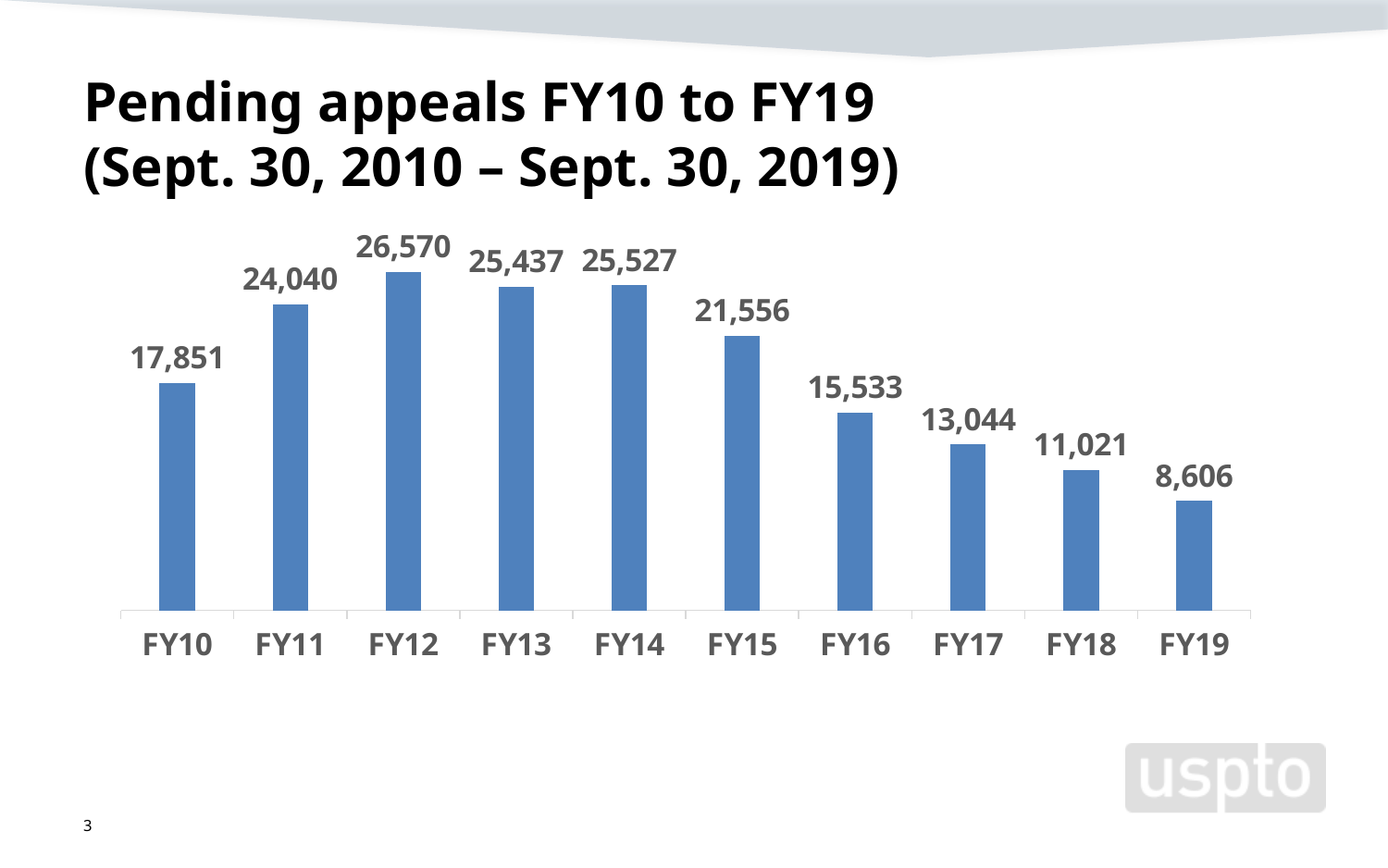
What is the title of the chart on the slide? Pending appeals FY10 to FY19 (Sept. 30, 2010 – Sept. 30, 2019) Which has more pending appeals, FY16 or FY17? FY16 How many fiscal years are shown on the chart? 10 What kind of chart is shown on the slide? Bar chart Do pending appeals rise or fall from FY14 to FY19? Fall Which fiscal year has the highest number of pending appeals? FY12 What is the number of pending appeals for FY19? 8,606 What is the difference in pending appeals between FY12 and FY19? 17,964 What is the number of pending appeals for FY15? 21,556 Which fiscal year has the lowest number of pending appeals? FY19 What is the difference in pending appeals between FY10 and FY11? 6,189 What is the number of pending appeals for FY12? 26,570